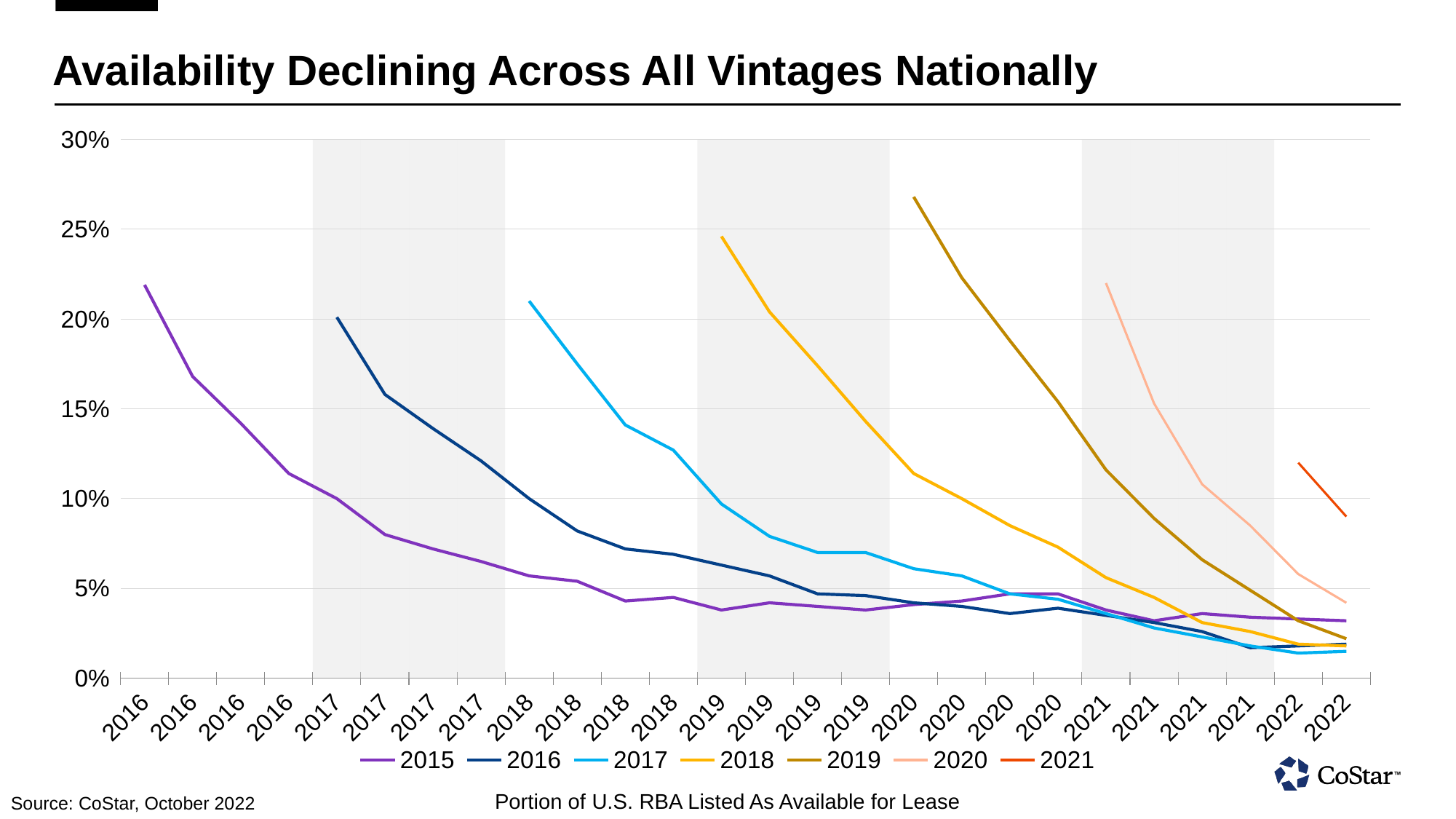
How many series does the legend list? 7 What is the title of the chart on the slide? Availability Declining Across All Vintages Nationally Which series has the highest value at the last point on the x axis (2022)? 2021 Which series starts at a higher value, 2018 or 2019? 2019 What kind of chart is shown on the slide? line chart Does the 2015 series rise or fall along the x axis? fall Which series reaches the highest value shown on the chart? 2019 Is the starting value of the 2021 series greater or less than 10%? greater What is the source cited for the chart? CoStar, October 2022 Is the starting value of the 2015 series greater or less than 20%? greater Is the starting value of the 2019 series greater or less than 25%? greater